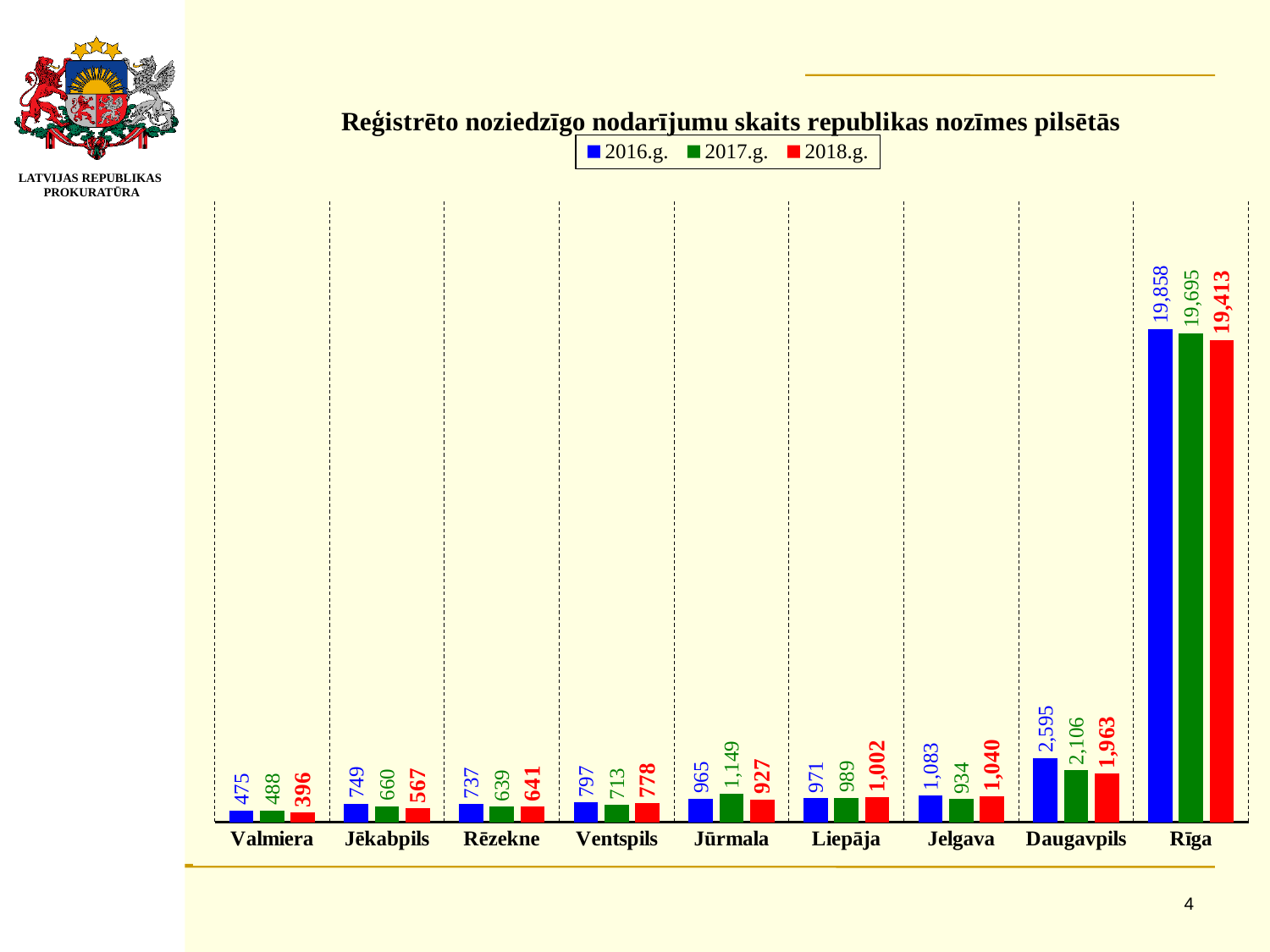
What is the difference between the 2016.g. and 2018.g. values for Daugavpils? 632 What kind of chart is shown on the slide? Bar chart What is the value for Rīga in 2018.g.? 19,413 Which is larger for Liepāja: the 2017.g. value or the 2018.g. value? 2018.g. Which city has the lowest value in 2016.g.? Valmiera Do the 2018.g. values for Rēzekne, Ventspils and Jūrmala rise or fall from Rēzekne to Jūrmala? Rise Which city has the highest value in 2018.g.? Rīga How many cities are shown on the x axis? 9 What is the value for Valmiera in 2018.g.? 396 What is the value for Daugavpils in 2016.g.? 2,595 What is the value for Jūrmala in 2017.g.? 1,149 How many series does the legend list? 3